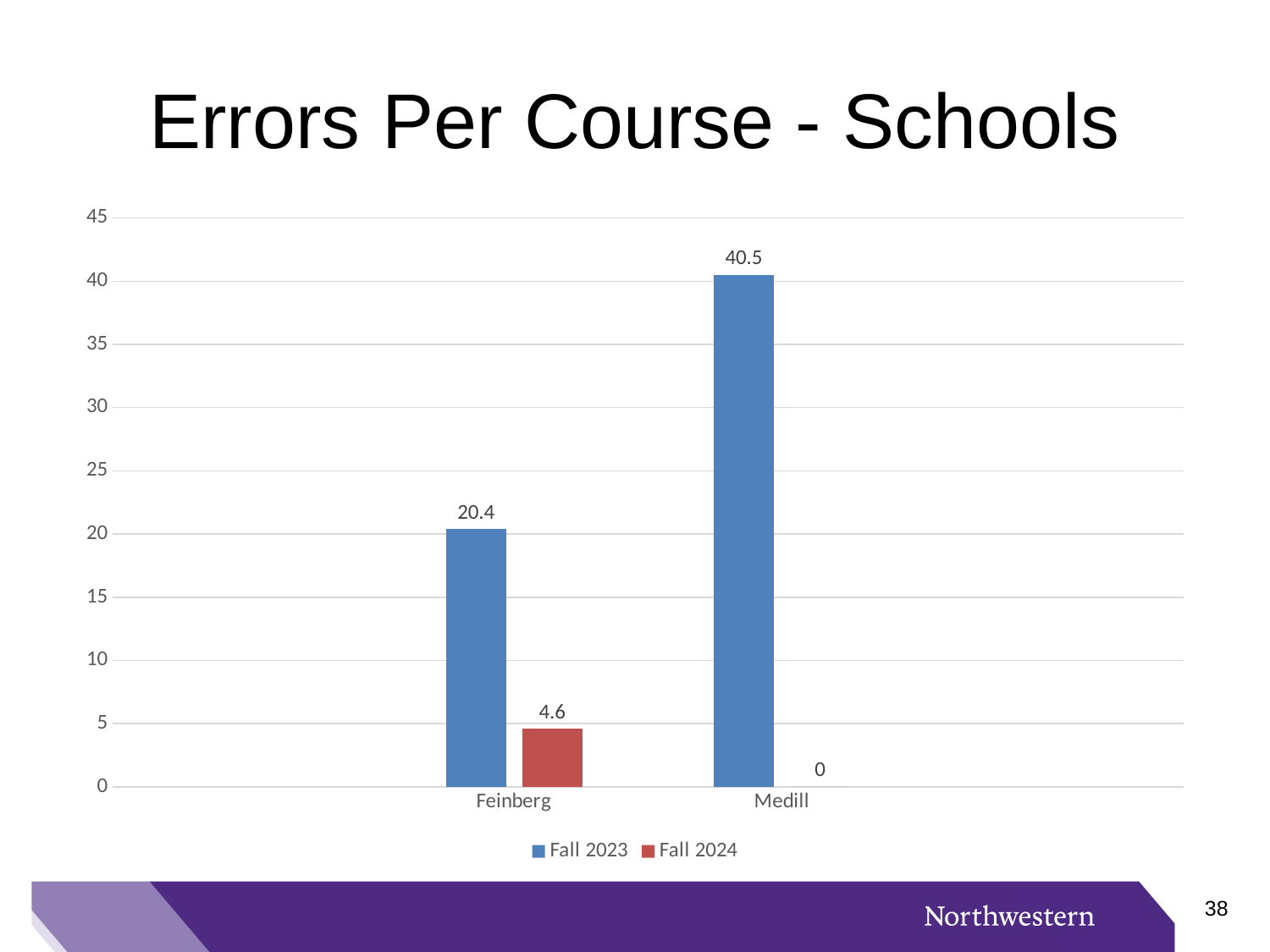
What is the Fall 2024 value for Medill? 0 How many series does the legend list? 2 Which school has the lowest Fall 2024 value? Medill What kind of chart is shown on the slide? Bar chart What is the difference between the Fall 2023 values for Medill and Feinberg? 20.1 Which school has the highest Fall 2023 value? Medill What is the Fall 2023 value for Medill? 40.5 What is the difference between the Fall 2023 and Fall 2024 values for Feinberg? 15.8 What is the Fall 2023 value for Feinberg? 20.4 How many schools are shown on the x axis? 2 Which is larger: the Fall 2023 value for Feinberg or the Fall 2023 value for Medill? Medill What is the Fall 2024 value for Feinberg? 4.6